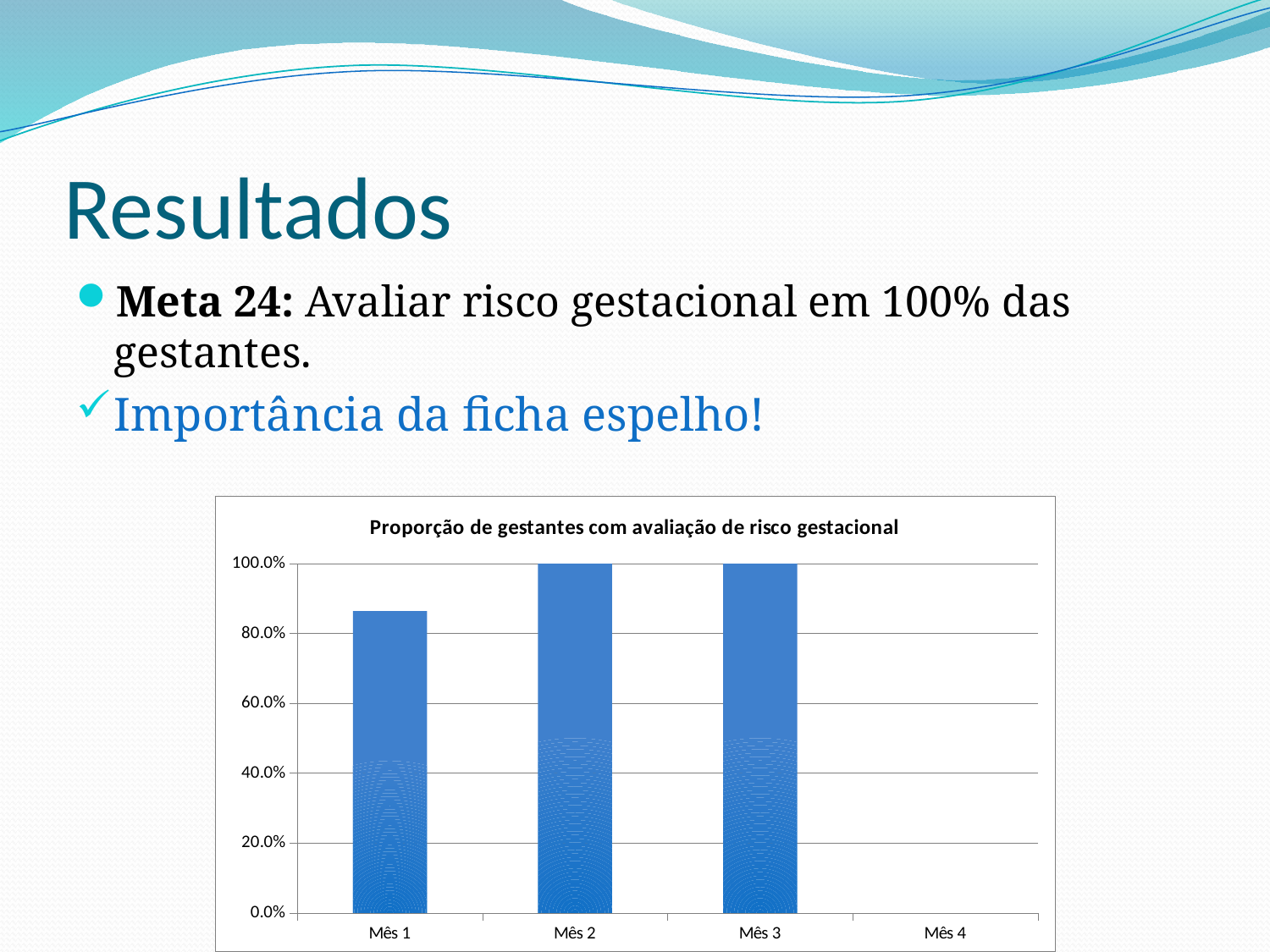
Which month has the lowest value? Mês 4 What is the title of the chart? Proporção de gestantes com avaliação de risco gestacional What type of chart is shown on the slide? bar chart What is the value for Mês 4? 0.0% How many categories are shown on the x axis of the chart? 4 Is the value for Mês 1 greater or less than 80.0%? greater Which is larger, the value for Mês 1 or the value for Mês 2? Mês 2 What is the value for Mês 3? 100.0% What is the difference between the values for Mês 2 and Mês 4? 100.0% Is the value for Mês 1 greater or less than 100.0%? less Does the value rise or fall from Mês 1 to Mês 2? rise What is the value for Mês 2? 100.0%